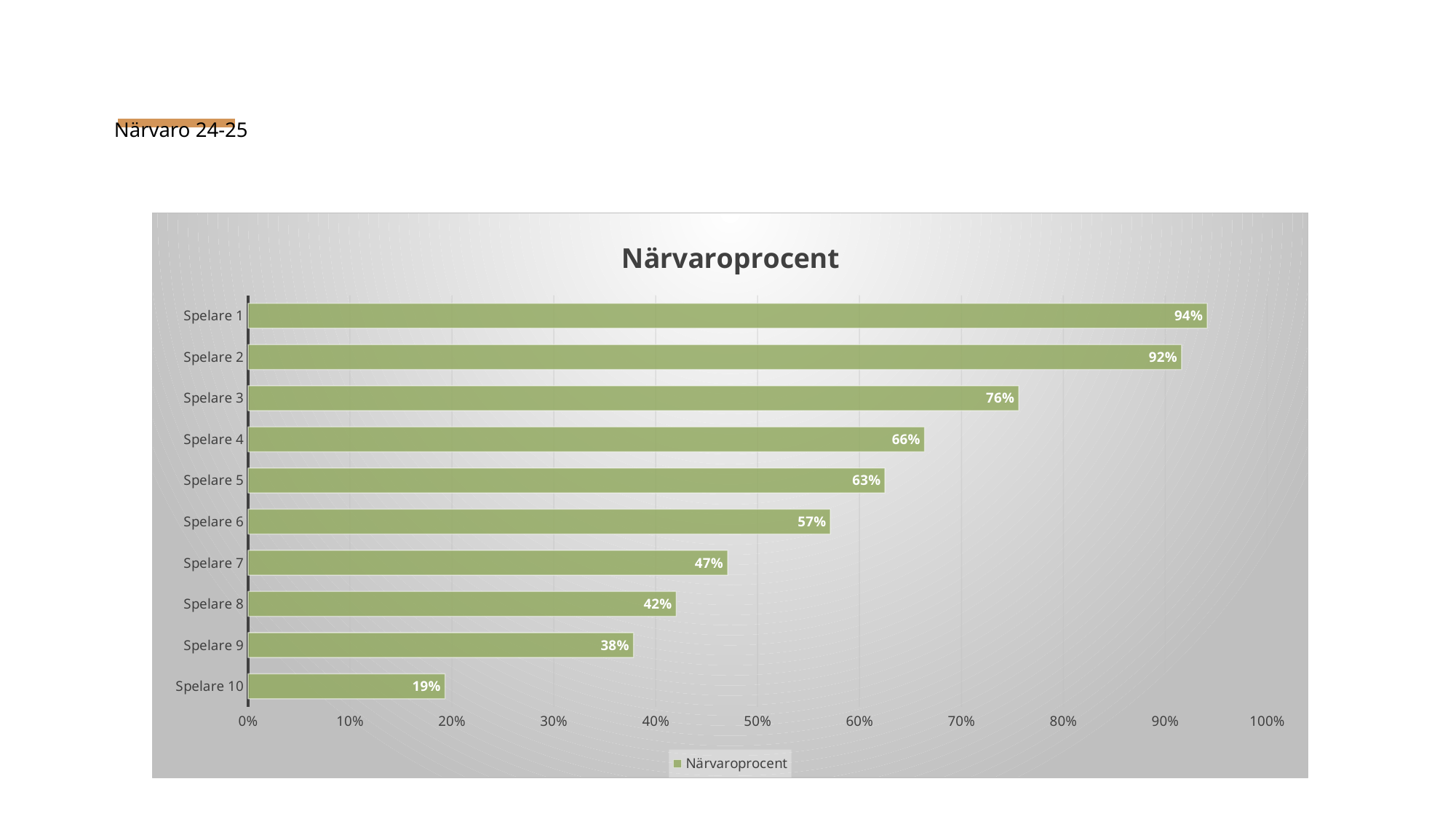
Which player has the lowest attendance percentage? Spelare 10 What is the difference between the values for Spelare 4 and Spelare 9? 28% What is the title of the chart? Närvaroprocent How many series does the legend list? 1 What is the value shown for Spelare 7? 47% Which player has the highest attendance percentage? Spelare 1 What kind of chart is shown on the slide? bar chart Which has a higher value, Spelare 5 or Spelare 6? Spelare 5 What is the attendance percentage for Spelare 3? 76% How many players are shown in the chart? 10 What is the difference between the values for Spelare 1 and Spelare 2? 2% Is the value for Spelare 8 greater or less than 50%? less